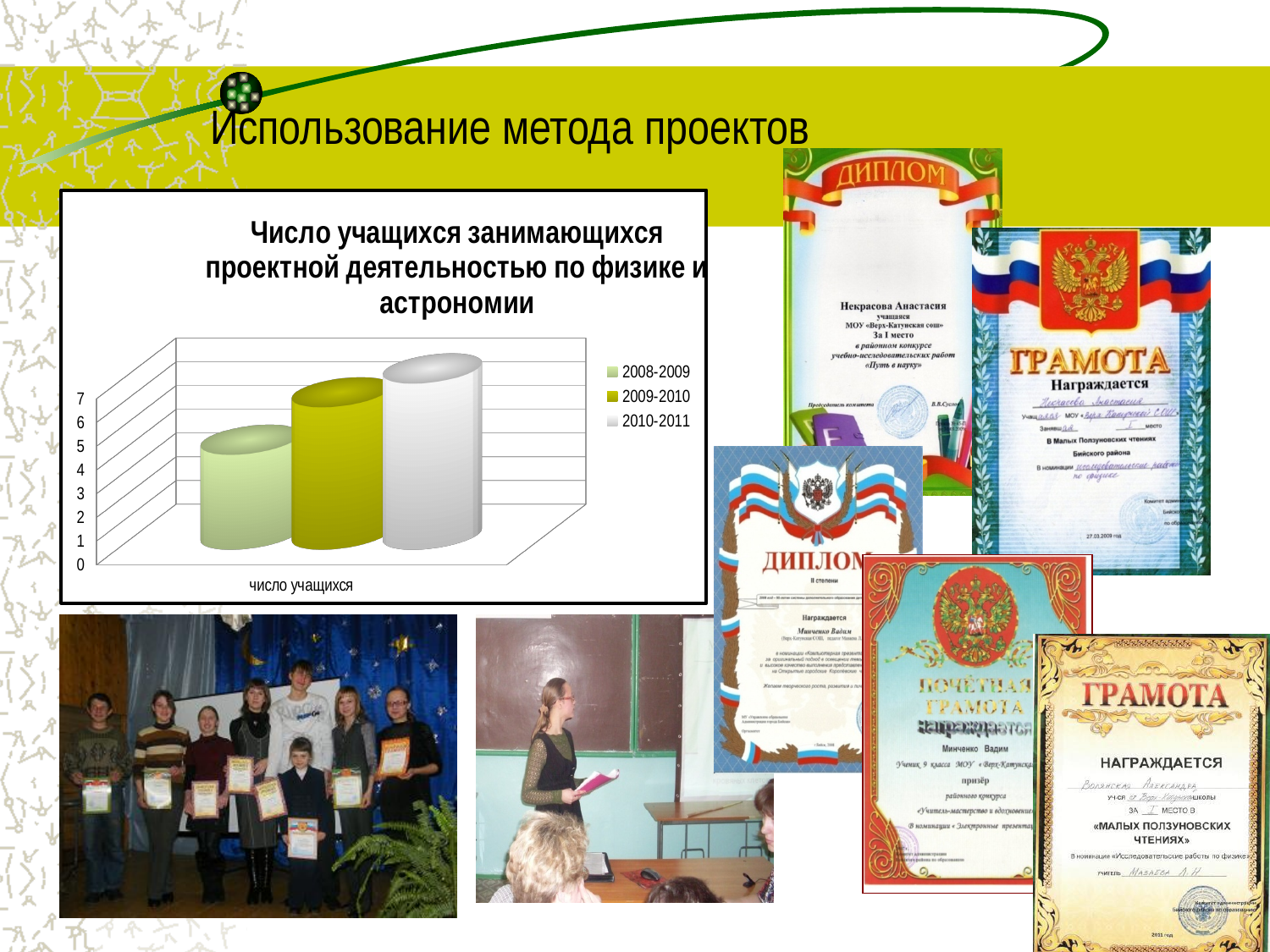
How many series does the chart legend list? 3 Which series has the lowest value in the chart? 2008-2009 Which is larger, the value for 2009-2010 or the value for 2008-2009? 2009-2010 What is the title of the chart? Число учащихся занимающихся проектной деятельностью по физике и астрономии What is the category label shown on the x axis of the chart? число учащихся Is the value for 2008-2009 greater or less than 6? less Do the values rise or fall from 2008-2009 to 2010-2011? rise What kind of chart is shown on the slide? bar chart Is the value for 2010-2011 greater or less than 5? greater Is the value for 2009-2010 greater or less than 4? greater What is the highest value shown on the chart's vertical axis? 7 Which series has the highest value in the chart? 2010-2011